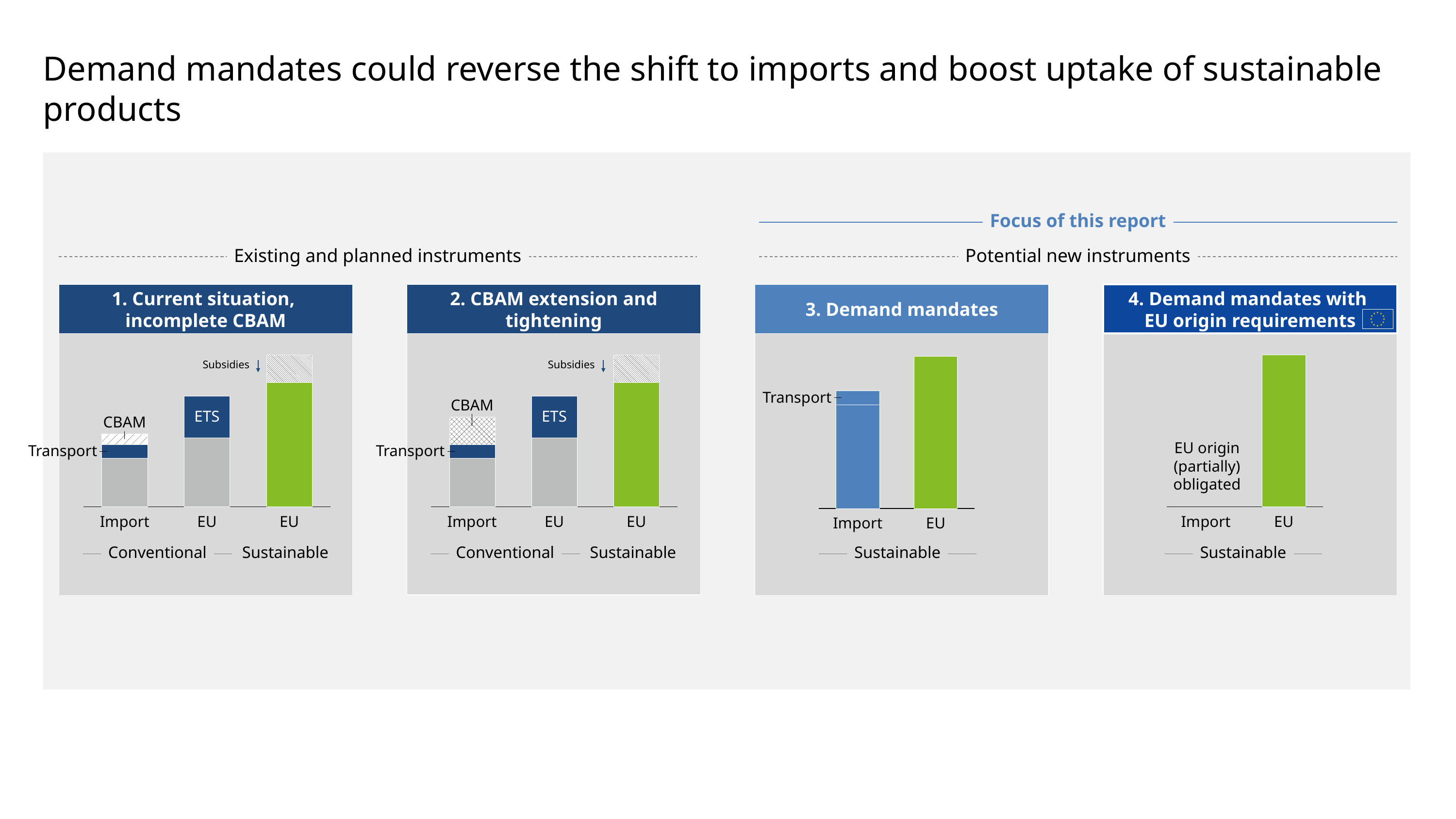
How many bars are plotted in the panel titled "1. Current situation, incomplete CBAM"? 3 In the panel titled "2. CBAM extension and tightening", which bar is the tallest? EU (Sustainable) In the panel titled "3. Demand mandates", what label is attached to the top segment of the Import bar? Transport In the panel titled "1. Current situation, incomplete CBAM", which bar is the tallest? EU (Sustainable) In the panel titled "1. Current situation, incomplete CBAM", what label is shown on the dark blue segment of the Conventional EU bar? ETS How many bars are plotted in the panel titled "3. Demand mandates"? 2 What kind of chart is shown in the panel titled "1. Current situation, incomplete CBAM"? bar chart How many panels (charts) are shown on the slide? 4 In the panel titled "1. Current situation, incomplete CBAM", which bar is taller, the Conventional Import bar or the Conventional EU bar? EU In the panel titled "3. Demand mandates", which bar is taller, Import or EU? EU In the panel titled "4. Demand mandates with EU origin requirements", which category has a plotted bar? EU Which panel is marked as the "Focus of this report"? Potential new instruments (panels 3 and 4)